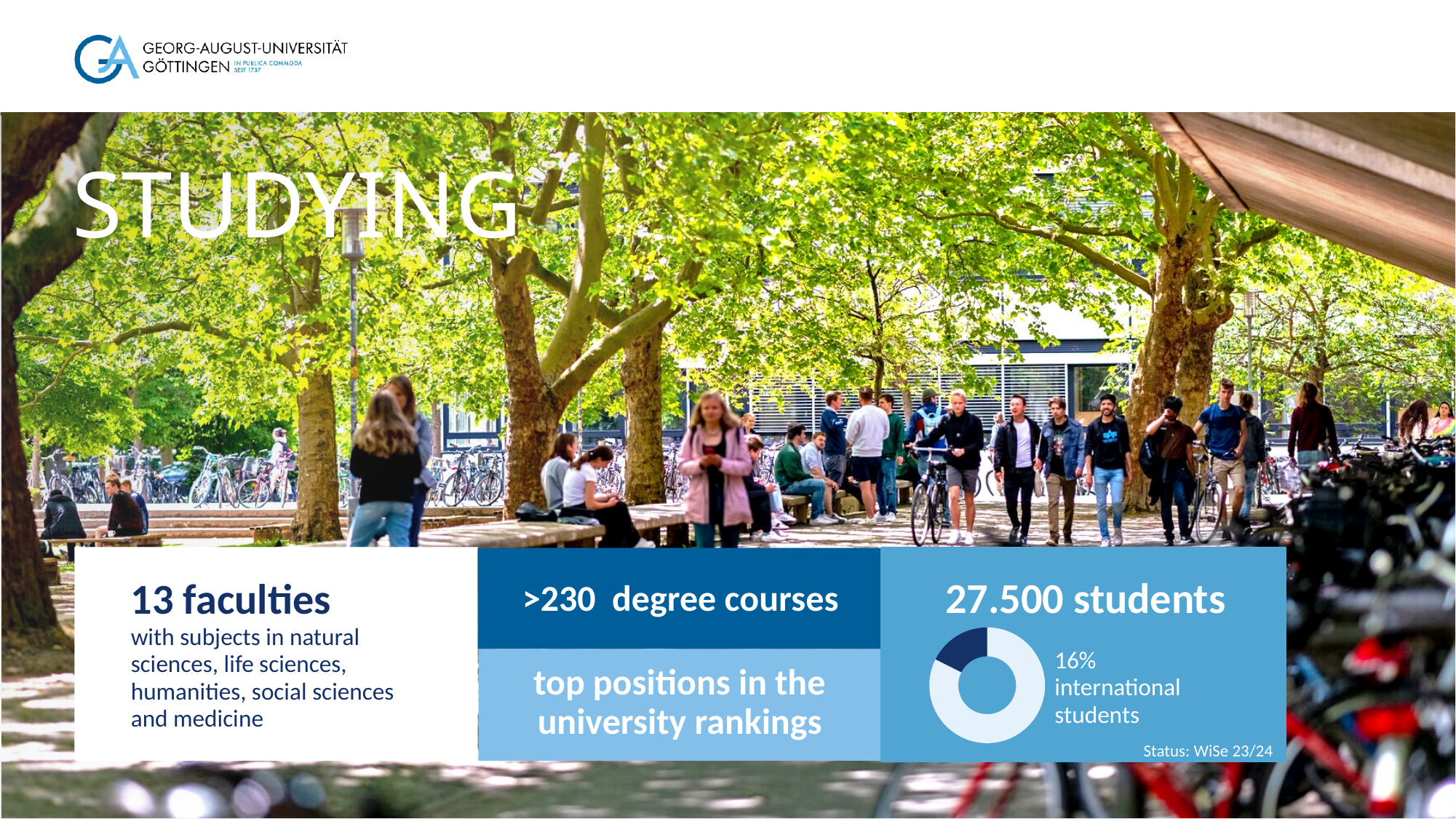
Which slice of the donut chart is larger, the dark blue one or the light blue one? the light blue one How many slices does the donut chart have? 2 What does the dark blue slice of the donut chart stand for? international students What status date is given for the donut chart data? WiSe 23/24 Is the share of international students shown in the donut chart greater or less than 50%? less What kind of chart is shown in the '27.500 students' box? pie chart (donut) What share of students does the dark blue slice of the donut chart represent? 16%